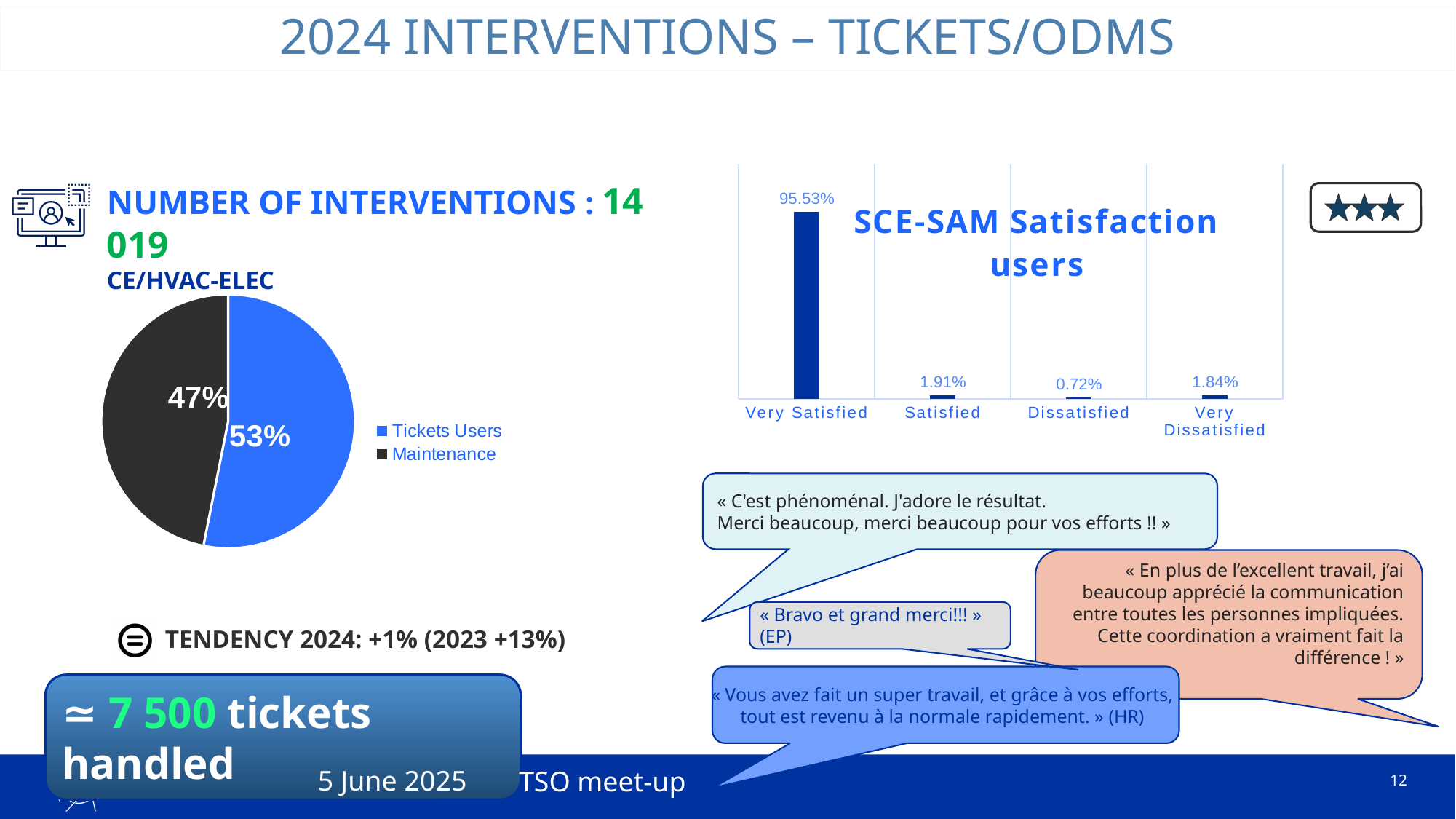
In the SCE-SAM Satisfaction users chart, what is the value for Very Satisfied? 95.53% In the pie chart on the left, what share is labelled for Maintenance? 47% In the SCE-SAM Satisfaction users chart, what is the difference between the Satisfied and Very Dissatisfied values? 0.07% In the pie chart on the left, what share is labelled for Tickets Users? 53% In the pie chart on the left, which slice is larger, Tickets Users or Maintenance? Tickets Users What kind of chart is the chart on the left of the slide? Pie chart In the SCE-SAM Satisfaction users chart, which category has the lowest value? Dissatisfied In the SCE-SAM Satisfaction users chart, how many categories are shown on the x axis? 4 In the pie chart on the left, what is the difference between the Tickets Users share and the Maintenance share? 6% How many entries does the legend of the pie chart on the left list? 2 In the SCE-SAM Satisfaction users chart, which category has the highest value? Very Satisfied In the SCE-SAM Satisfaction users chart, what is the value for Dissatisfied? 0.72%